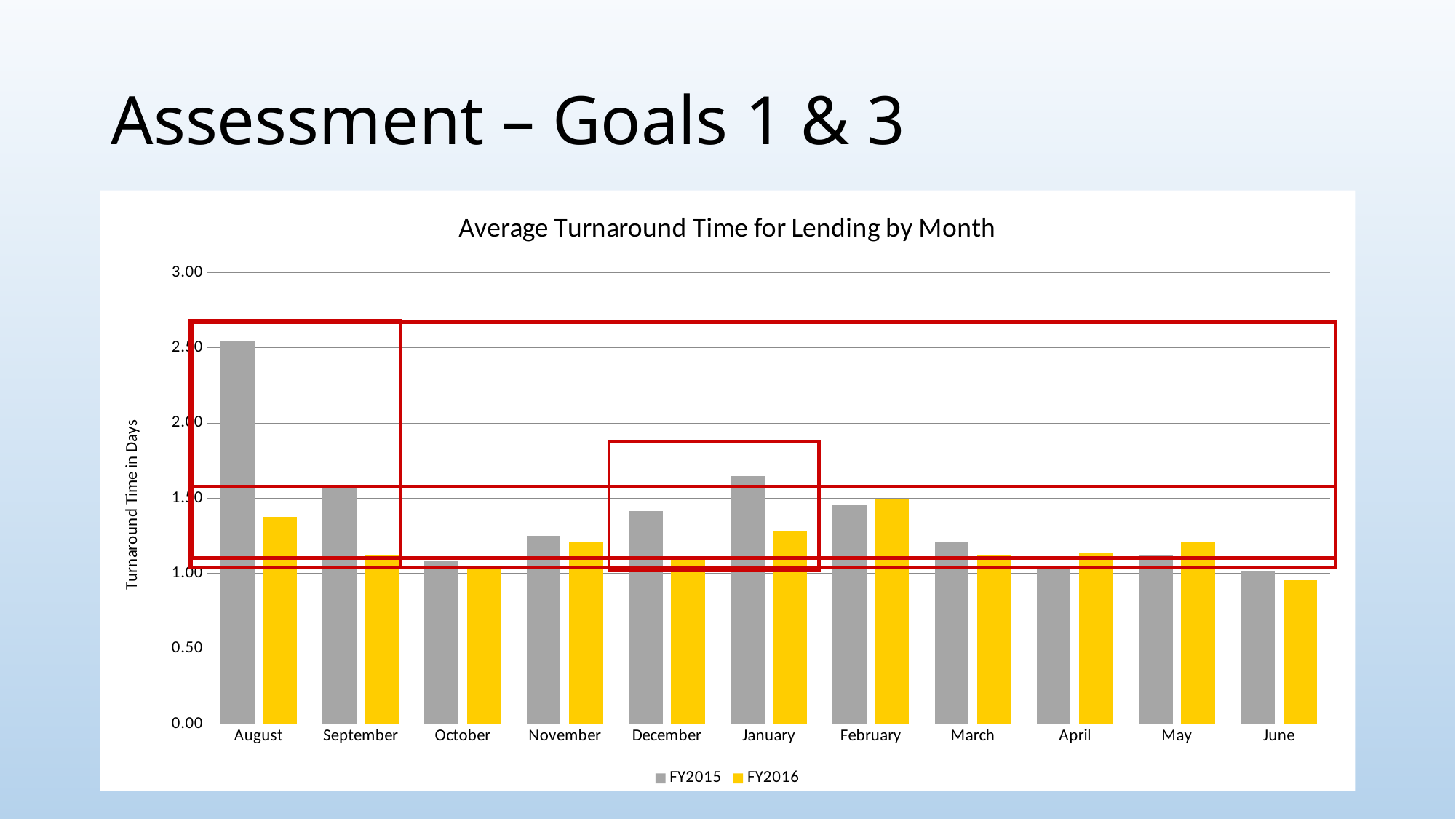
How many series does the legend list? 2 Which month has the lowest FY2016 turnaround time? June Is the FY2016 value for June greater or less than 1.00? less For May, which series has the larger value, FY2015 or FY2016? FY2016 What kind of chart is shown on the slide? Bar chart For September, which series has the larger value, FY2015 or FY2016? FY2015 How many months are shown on the x axis? 11 What is the title of the chart? Average Turnaround Time for Lending by Month Which month has the highest FY2016 turnaround time? February Is the FY2015 value for August greater or less than 2.00? greater Which month has the highest FY2015 turnaround time? August Is the FY2015 value for January greater or less than 1.50? greater